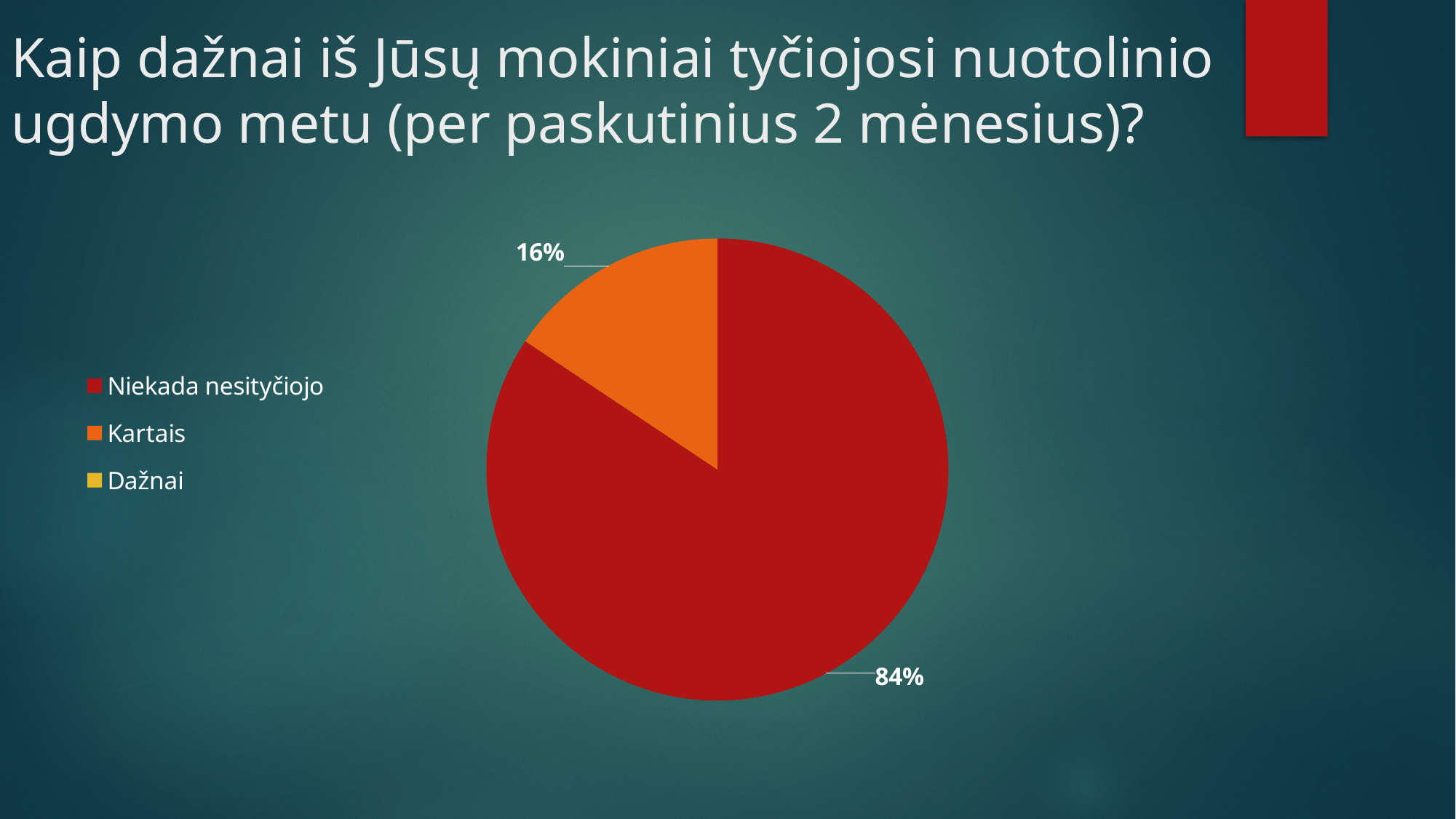
What share of the pie does "Niekada nesityčiojo" take? 84% How many entries does the legend list? 3 Which category has the largest slice of the pie? Niekada nesityčiojo Which of the two labelled slices is larger, "Kartais" or "Niekada nesityčiojo"? Niekada nesityčiojo Which legend entry is shown in yellow? Dažnai What kind of chart is shown on the slide? pie chart What share of the pie does "Kartais" take? 16% How many slices with a printed percentage label are visible in the pie? 2 What is the difference in percentage points between the "Niekada nesityčiojo" slice and the "Kartais" slice? 68 Is the share for "Kartais" greater or less than 50%? less What colour is the "Kartais" slice? orange